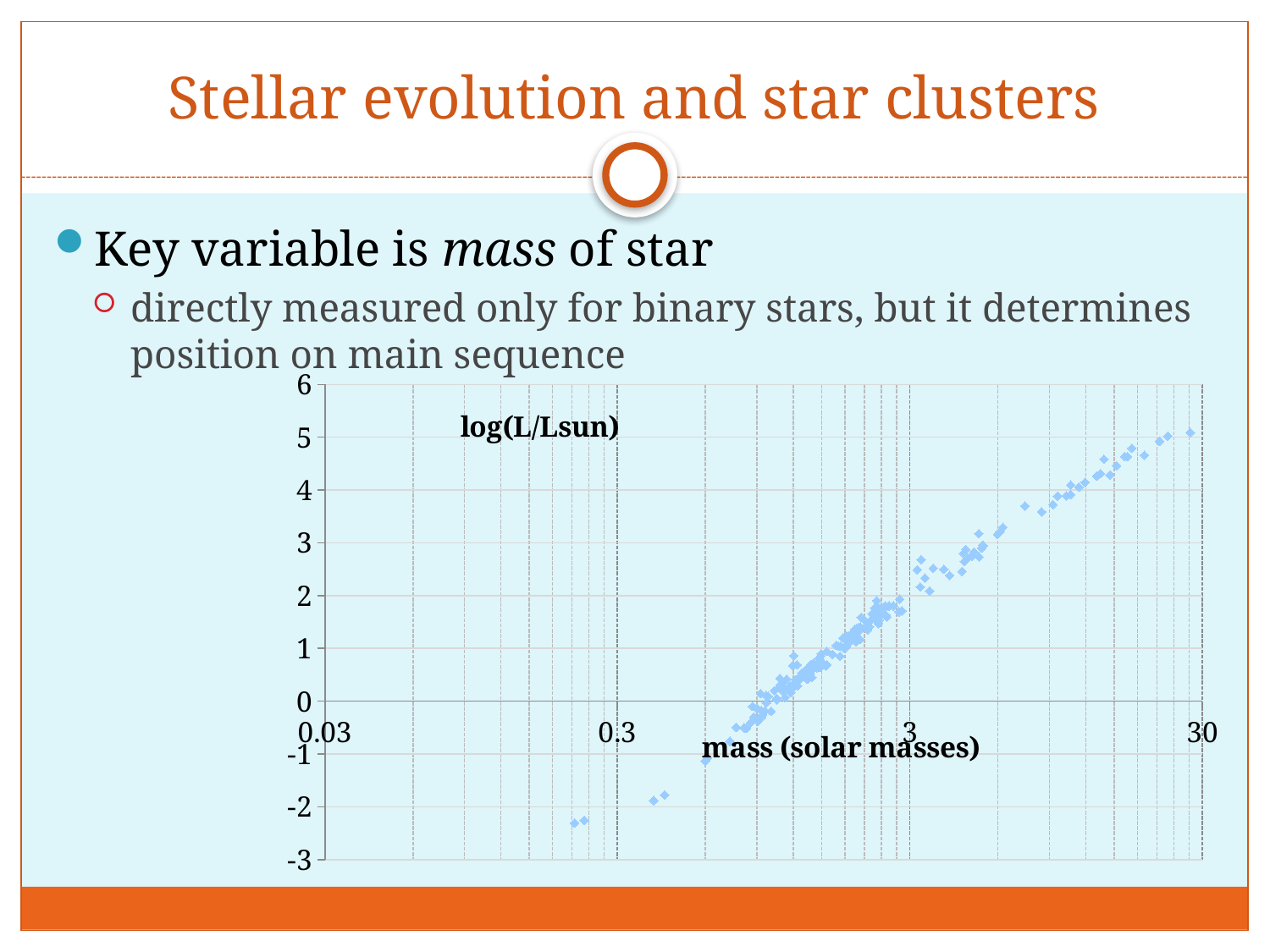
Are the log(L/Lsun) values for stars with mass below 0.3 solar masses greater or less than 0? less As mass increases along the x axis, does log(L/Lsun) rise or fall? rise What is the label of the horizontal axis of the chart? mass (solar masses) Do the stars with the highest log(L/Lsun) have the highest or the lowest mass? highest Is the log(L/Lsun) value for the star with mass near 30 solar masses greater or less than 4? greater What is the label of the vertical axis of the chart? log(L/Lsun) Are the log(L/Lsun) values for stars with mass near 3 solar masses greater or less than 1? greater What kind of chart is shown on the slide? scatter plot What is the highest tick value shown on the vertical axis? 6